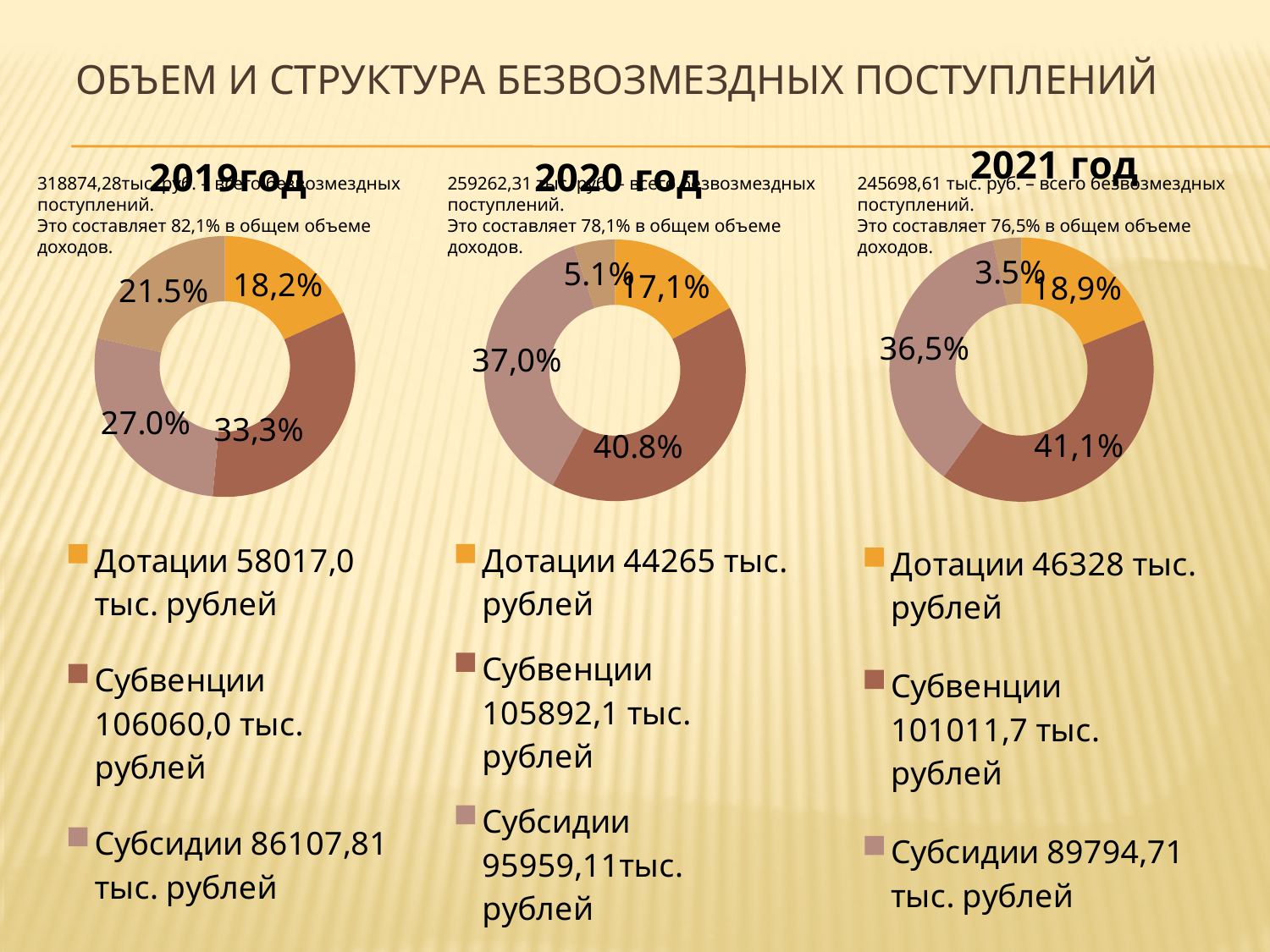
In the 2021 год chart, which category has the largest share? Субвенции How many slices does the 2020 год chart have? 4 How many entries does the legend under the 2019 год chart list? 3 What is the title of the slide? ОБЪЕМ И СТРУКТУРА БЕЗВОЗМЕЗДНЫХ ПОСТУПЛЕНИЙ In the 2021 год chart, what is the difference between the Субвенции share and the Дотации share? 22,2% In the 2020 год chart, which labelled slice has the smallest share? 5.1% In the 2019 год chart, which is larger: the Субсидии share or the Дотации share? Субсидии In the 2020 год chart, what share is shown for Субвенции? 40.8% In the 2019 год chart, what share is shown for Дотации? 18,2% What kind of chart is used for each year on this slide? Donut (pie) chart According to the legend of the 2020 год chart, what is the amount for Дотации? 44265 тыс. рублей In the 2021 год chart, what share is shown for Субсидии? 36,5%